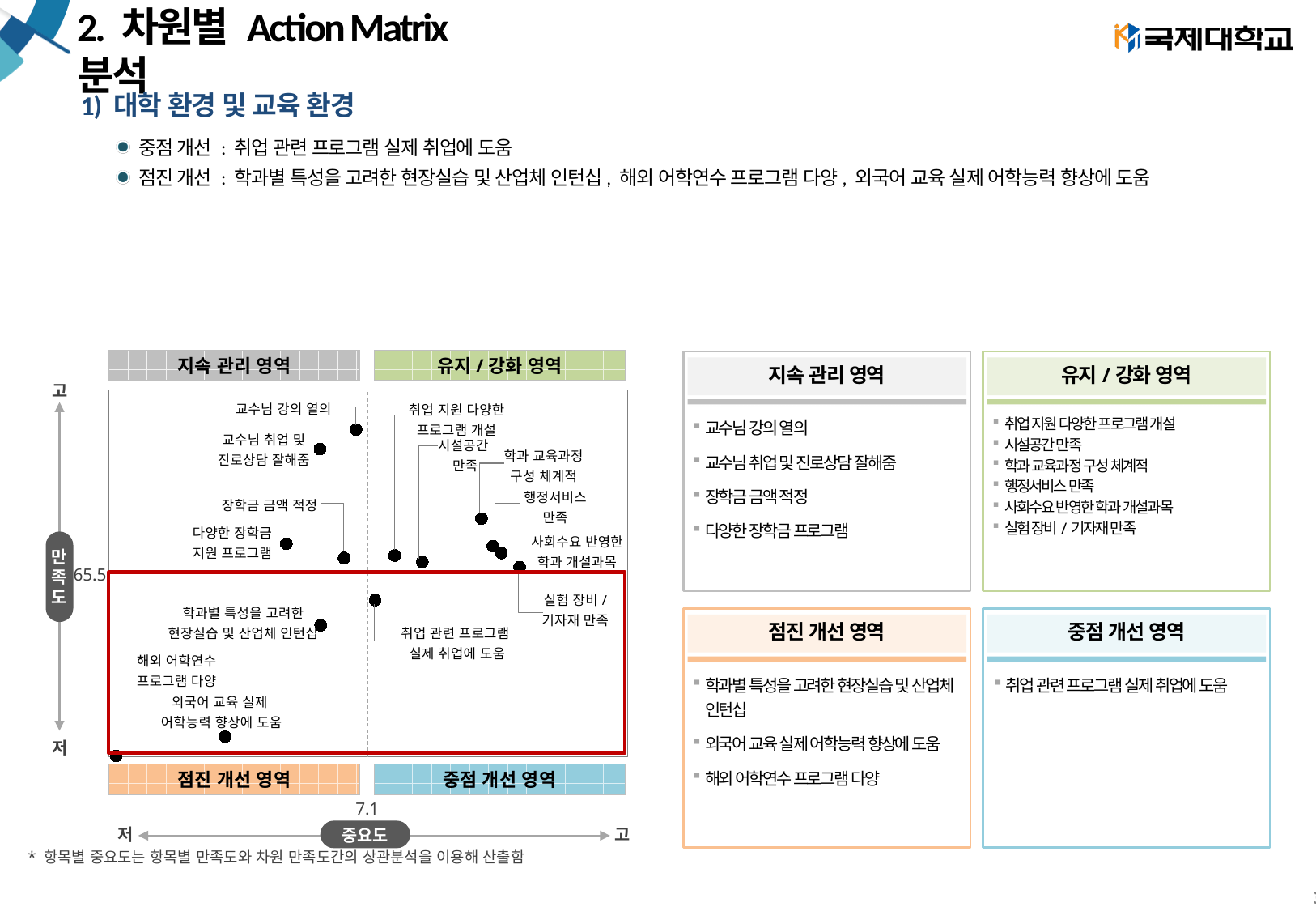
What kind of chart is shown on the slide? scatter chart Which item has the lowest 만족도 in the chart? 해외 어학연수 프로그램 다양 What 만족도 value marks the horizontal dividing line in the chart? 65.5 Is the 만족도 for 해외 어학연수 프로그램 다양 greater or less than 65.5? less How many data points are plotted in the action matrix chart? 14 Which item has the highest 만족도 in the chart? 교수님 강의 열의 How many items are plotted in the 점진 개선 영역 quadrant? 3 How many items are plotted in the 지속 관리 영역 quadrant? 4 What 중요도 value marks the vertical dividing line in the chart? 7.1 Which has the higher 만족도: 교수님 강의 열의 or 다양한 장학금 지원 프로그램? 교수님 강의 열의 Which item is plotted in the 중점 개선 영역 quadrant of the chart? 취업 관련 프로그램 실제 취업에 도움